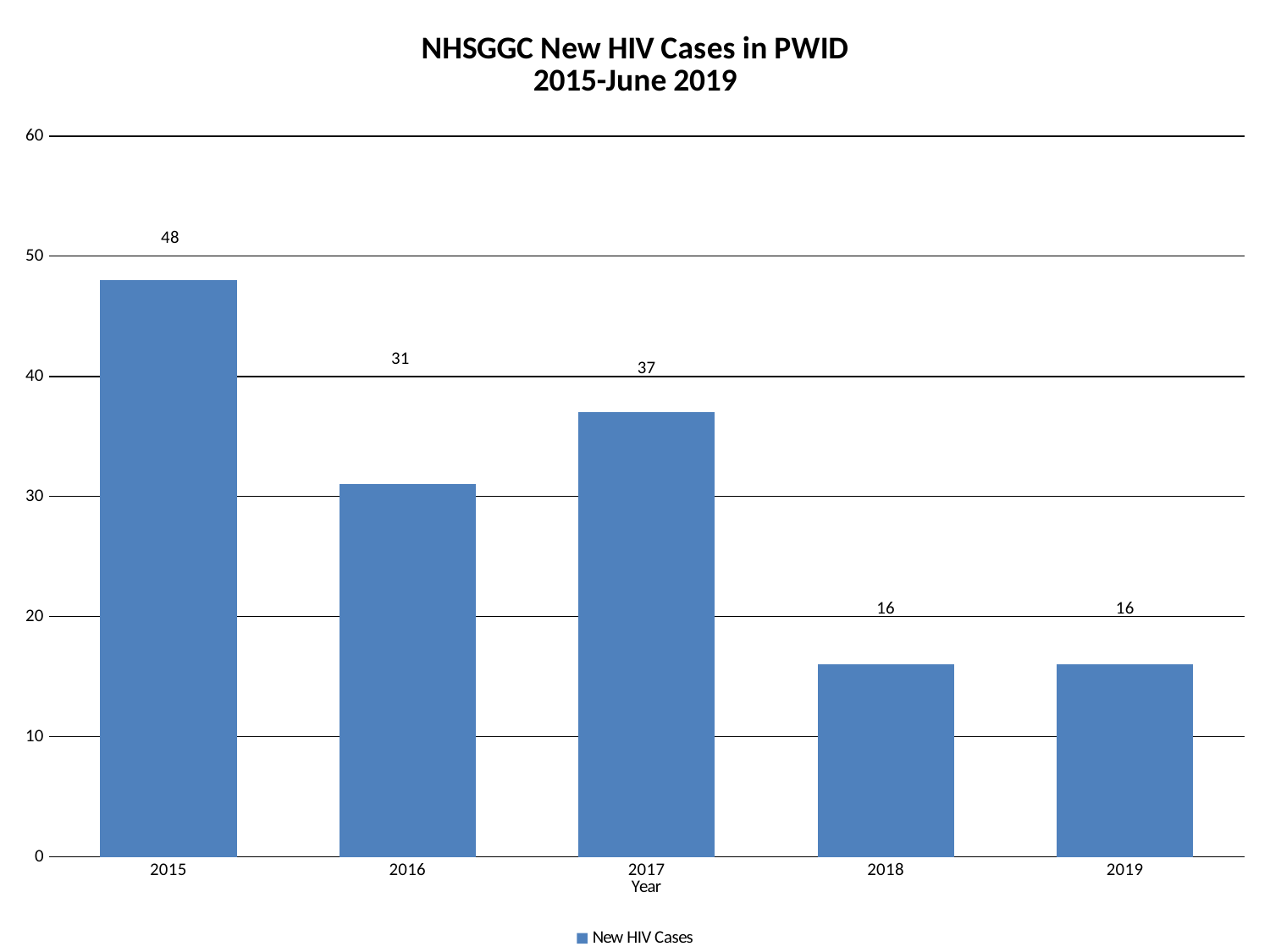
What is the difference between the values for 2015 and 2016? 17 Which year has the highest number of new HIV cases? 2015 Which is larger, the value for 2016 or the value for 2017? 2017 Is the value for 2016 greater or less than 40? less What is the title of the chart? NHSGGC New HIV Cases in PWID 2015-June 2019 What is the value for 2017? 37 What is the value for 2018? 16 What is the value for 2015? 48 What is the difference between the values for 2017 and 2019? 21 What kind of chart is this? bar chart How many years are shown on the x axis? 5 How many series does the legend list? 1